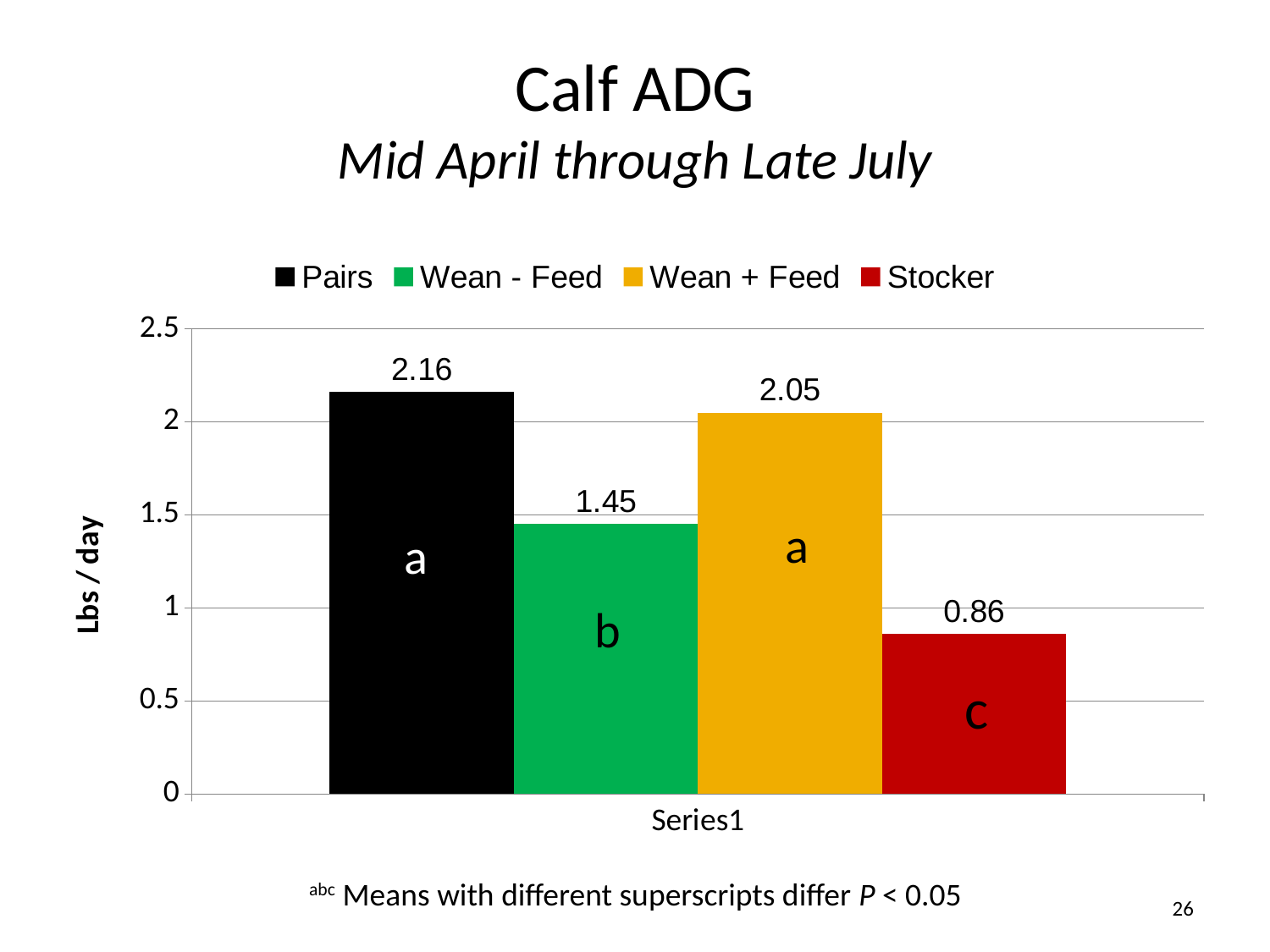
What is the calf ADG value for Wean - Feed? 1.45 What kind of chart is shown on the slide? bar chart Which has a higher calf ADG, Wean - Feed or Wean + Feed? Wean + Feed What is the calf ADG value for Pairs? 2.16 What is the calf ADG value for Wean + Feed? 2.05 What is the calf ADG value for Stocker? 0.86 Is the value for Stocker greater or less than 1? less How many series does the legend list? 4 Which group has the highest calf ADG? Pairs Which group has the lowest calf ADG? Stocker What is the difference in calf ADG between Wean + Feed and Wean - Feed? 0.60 What is the difference in calf ADG between Pairs and Stocker? 1.30